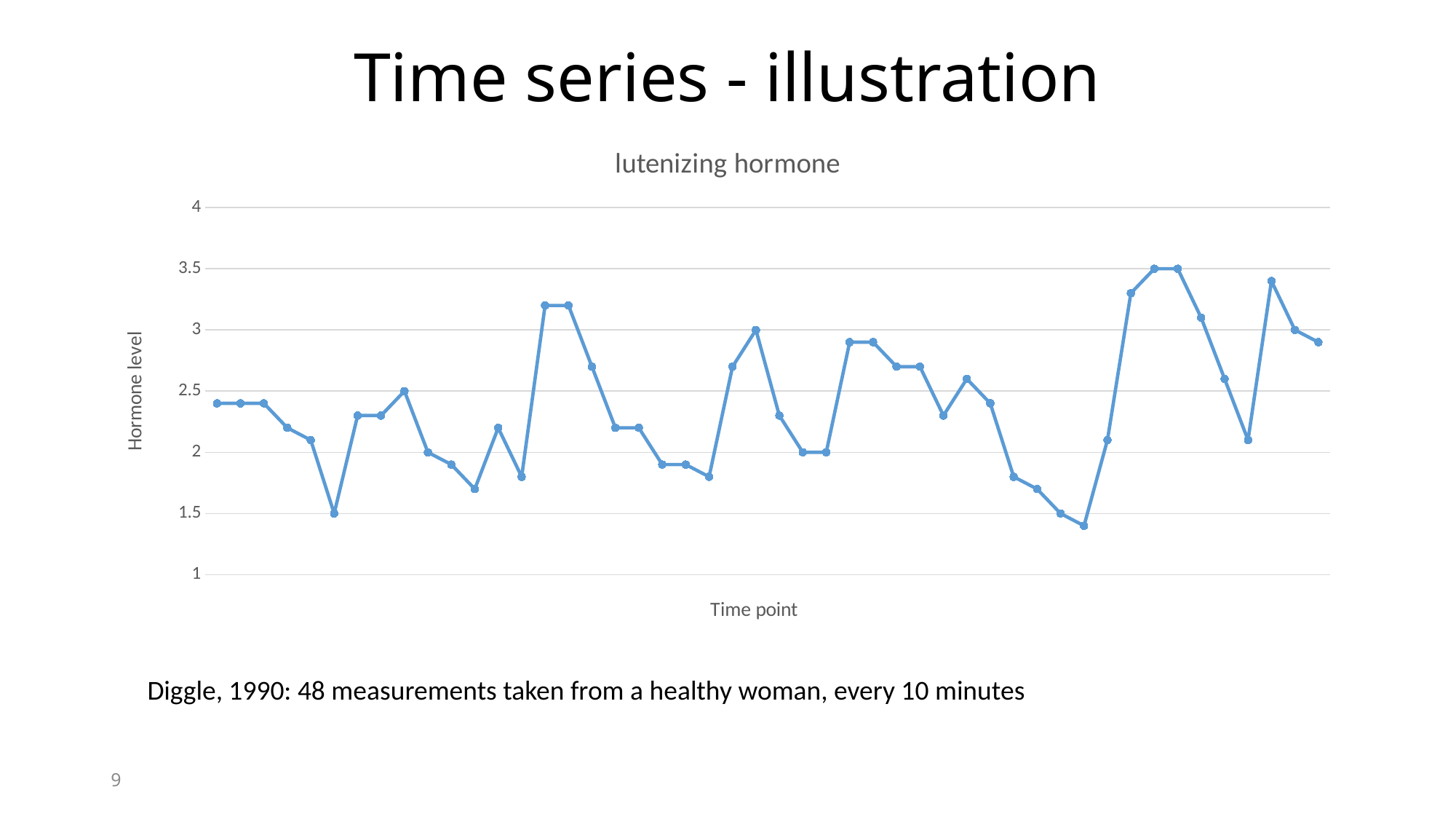
What is the highest hormone level reached in the chart? 3.5 What is the label of the vertical axis of the chart? Hormone level Is the last plotted value higher or lower than the first plotted value? higher What is the title of the chart? lutenizing hormone Is the last plotted value greater or less than 2.5? greater Is the highest value in the chart greater or less than 3? greater What kind of chart is shown on the slide? line chart Is the first plotted value greater or less than 2? greater How many measurements (data points) are plotted in the chart? 48 What is the maximum value shown on the vertical axis? 4